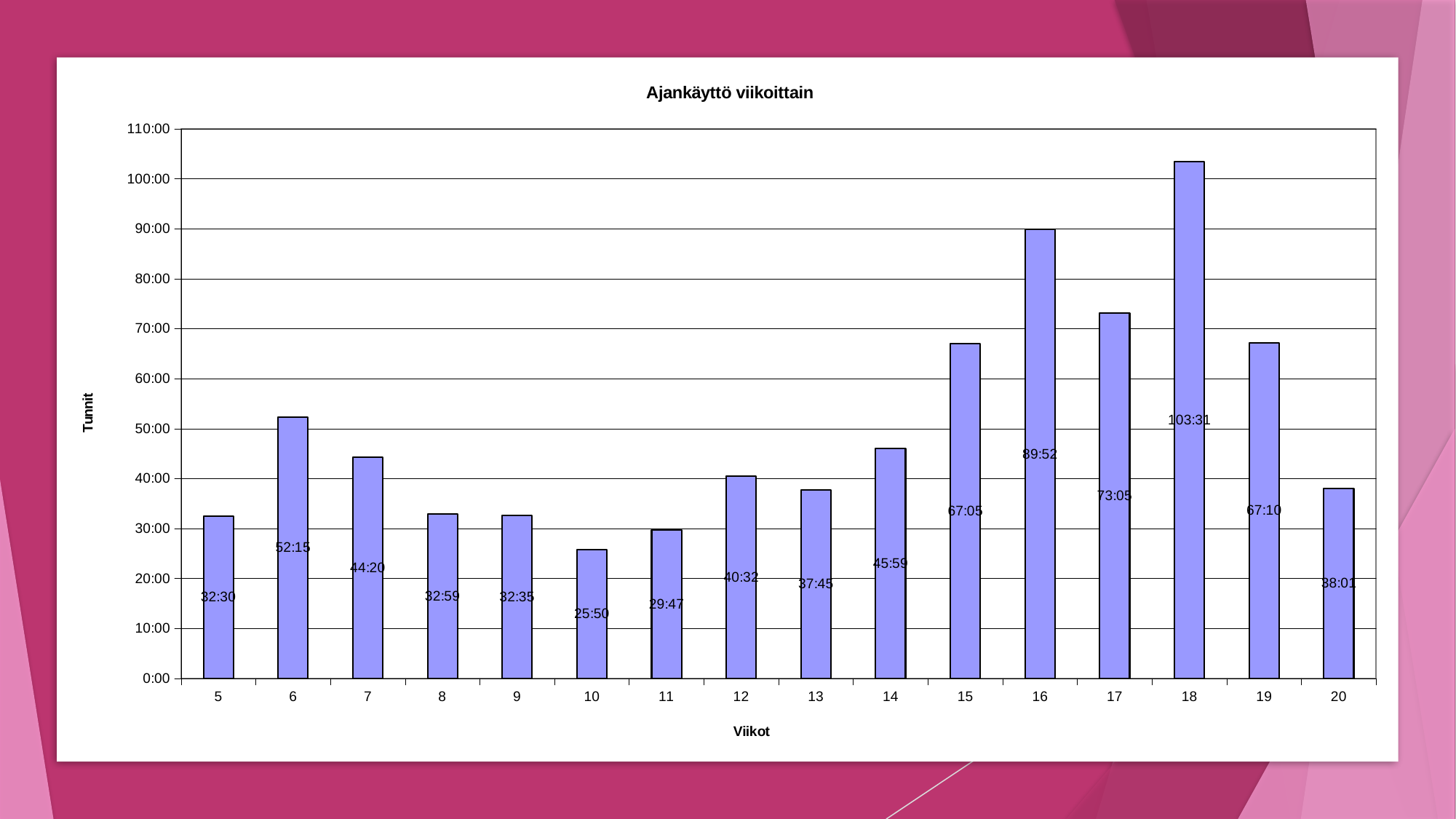
What is the value for week 18? 103:31 Which is larger, the value for week 6 or the value for week 7? week 6 What kind of chart is this? bar chart Is the value for week 16 greater or less than 80:00? greater What is the value for week 12? 40:32 What is the difference between the values for week 18 and week 16? 13:39 What is the title of the chart? Ajankäyttö viikoittain What is the value for week 10? 25:50 Which week has the highest value? 18 Do the values rise or fall from week 10 to week 18? rise Which week has the lowest value? 10 How many weeks are shown on the x axis? 16